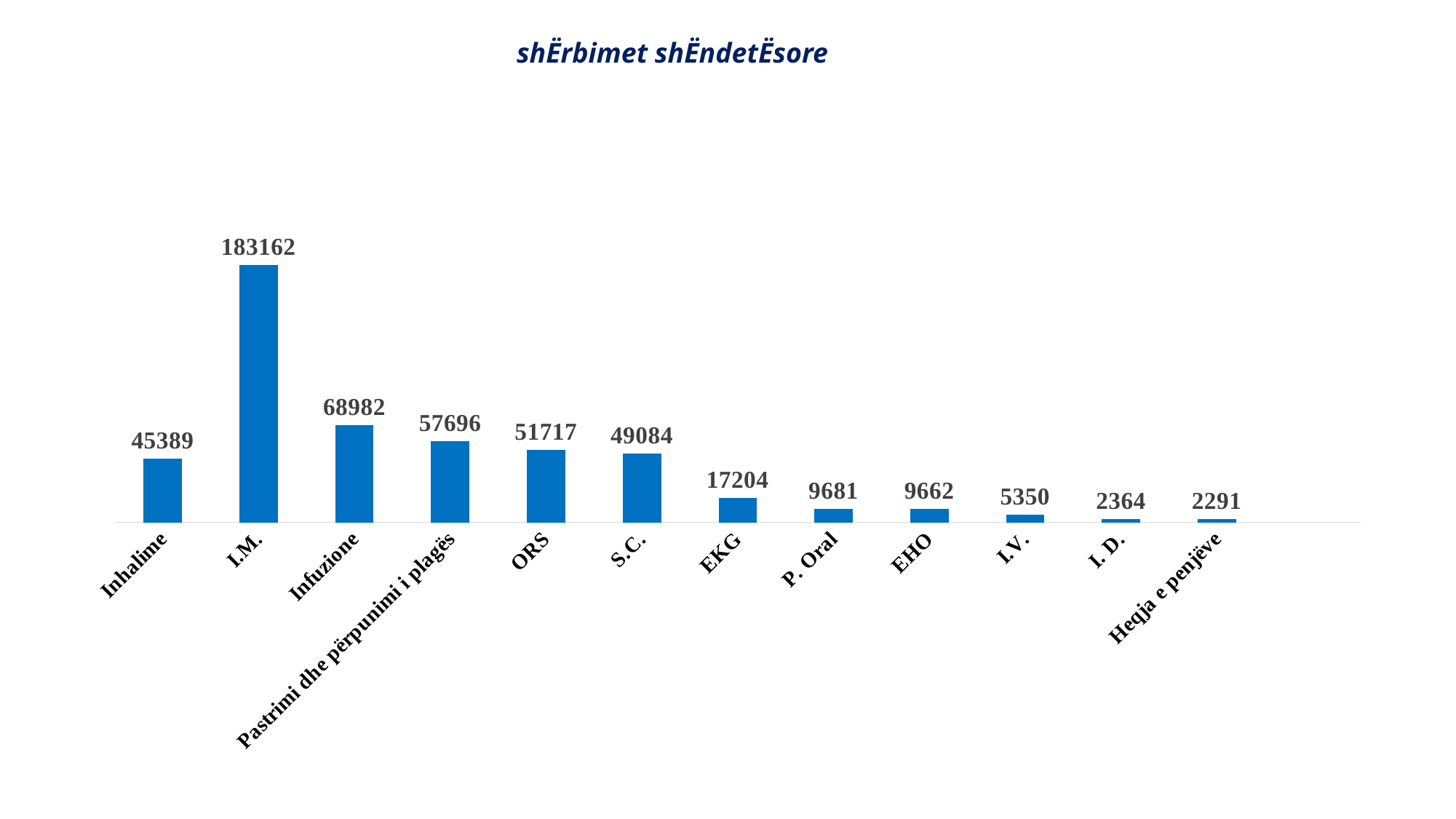
What is the difference between the values for ORS and S.C.? 2633 How many categories are shown in the chart? 12 Which is larger, the value for Inhalime or the value for Pastrimi dhe përpunimi i plagës? Pastrimi dhe përpunimi i plagës What is the title of the chart? shËrbimet shËndetËsore What is the difference between the values for I.M. and Infuzione? 114180 Which category has the lowest value? Heqja e penjëve Which category has the highest value? I.M. What is the value for Heqja e penjëve? 2291 What is the value for EKG? 17204 What is the value for I.M.? 183162 What is the value for Infuzione? 68982 What kind of chart is shown on the slide? bar chart